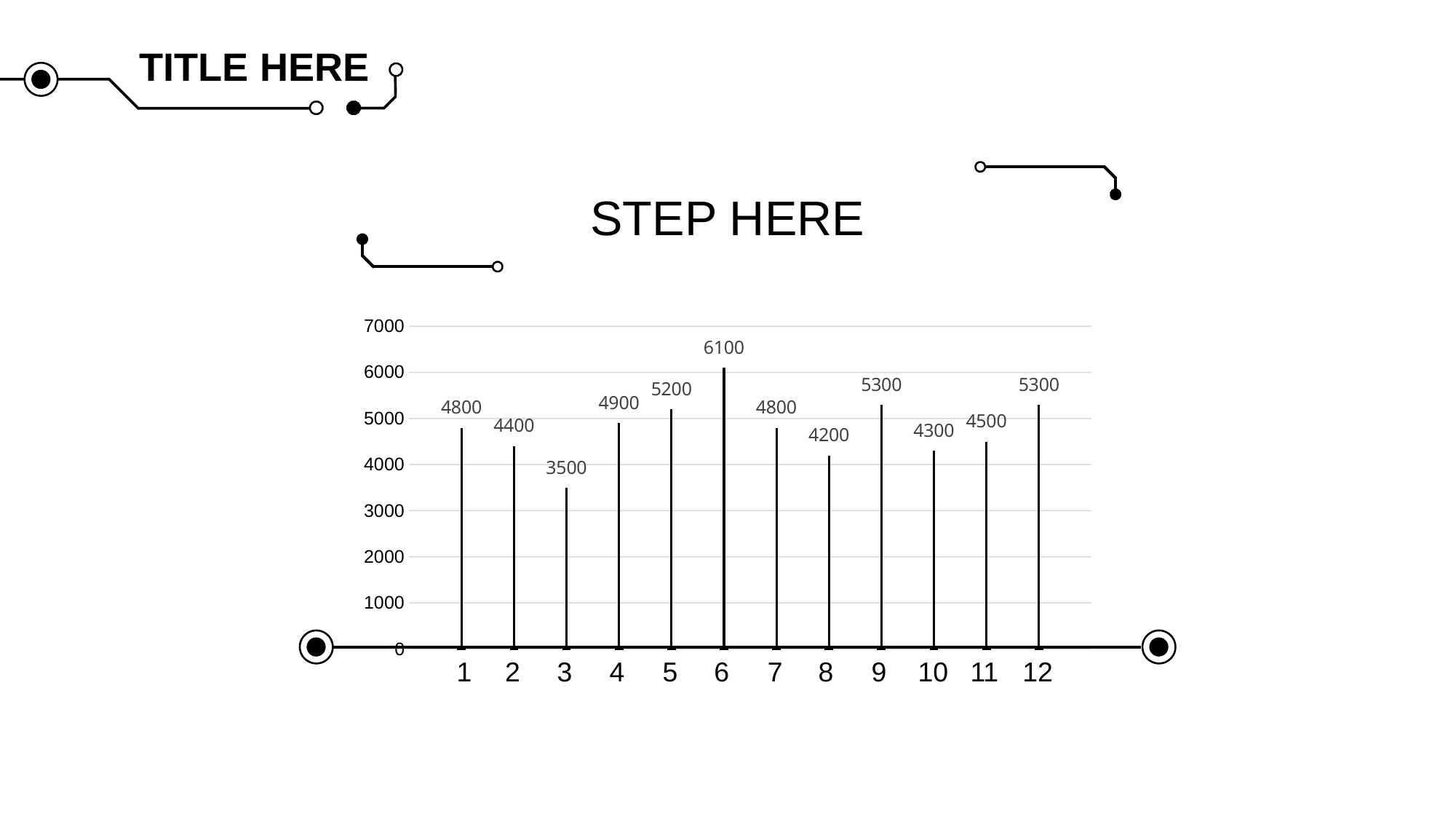
Which category has the lowest value? 3 Which category has the highest value? 6 What is the value for category 3? 3500 How many categories are shown on the x axis? 12 What kind of chart is shown on the slide? bar chart What is the value for category 6? 6100 Is the value for category 9 greater or less than 5000? greater What is the difference between the values for category 6 and category 3? 2600 What is the value for category 10? 4300 What is the difference between the values for category 5 and category 2? 800 Which is larger, the value for category 4 or the value for category 8? category 4 What is the title of the chart? STEP HERE